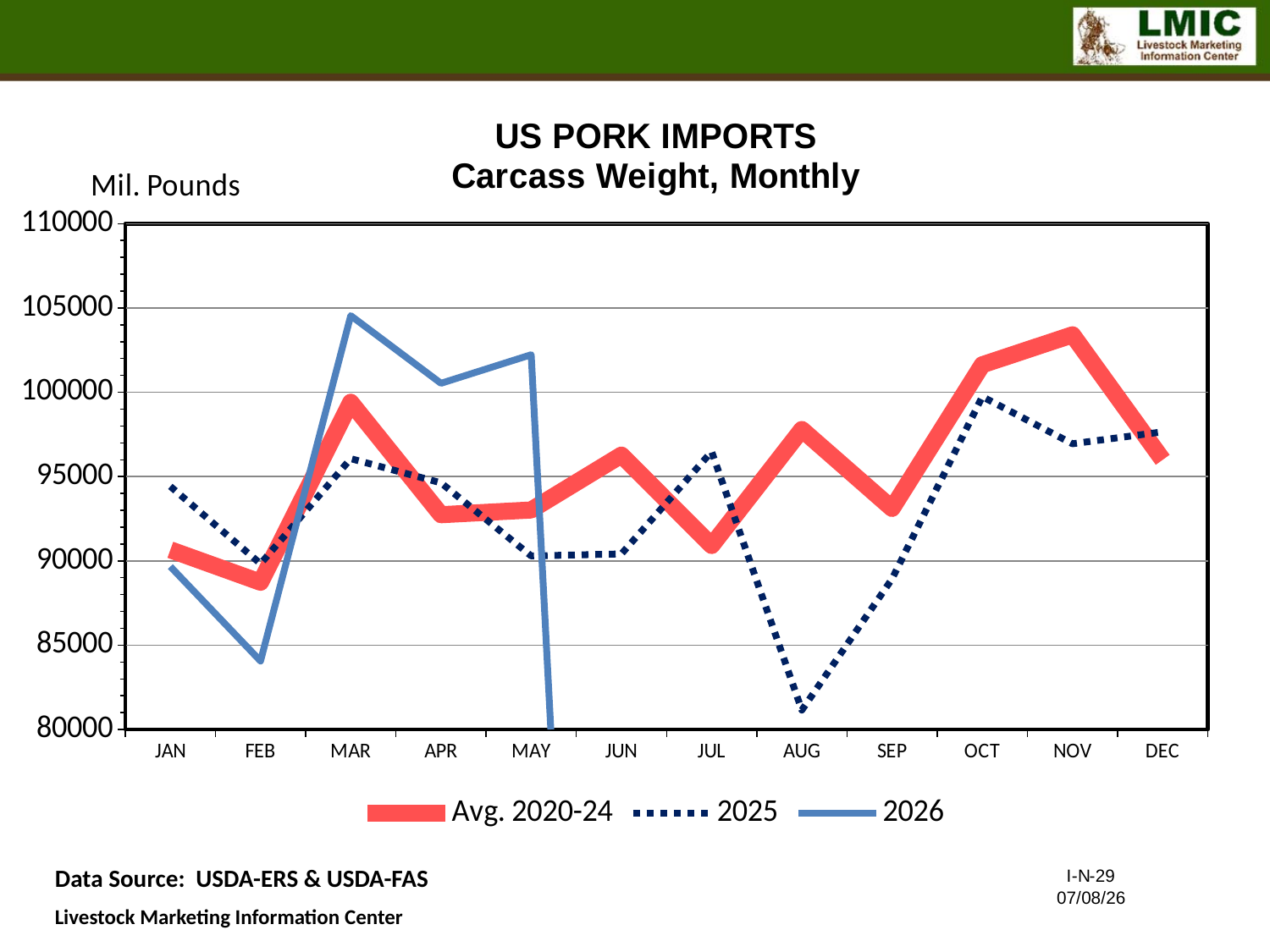
How many series does the legend list? 3 In which month does the 2025 series reach its lowest value? AUG Does the 2025 series rise or fall from JUL to AUG? fall Is the 2026 value for MAR greater or less than 100000? greater How many months are shown along the x axis? 12 In which month does the Avg. 2020-24 series reach its highest value? NOV Is the Avg. 2020-24 value for NOV greater or less than 100000? greater In which month does the 2026 series reach its highest value? MAR What unit label is shown above the y axis? Mil. Pounds What type of chart is shown on the slide? line chart In JAN, which series has the larger value, 2025 or 2026? 2025 Is the 2025 value for AUG greater or less than 85000? less